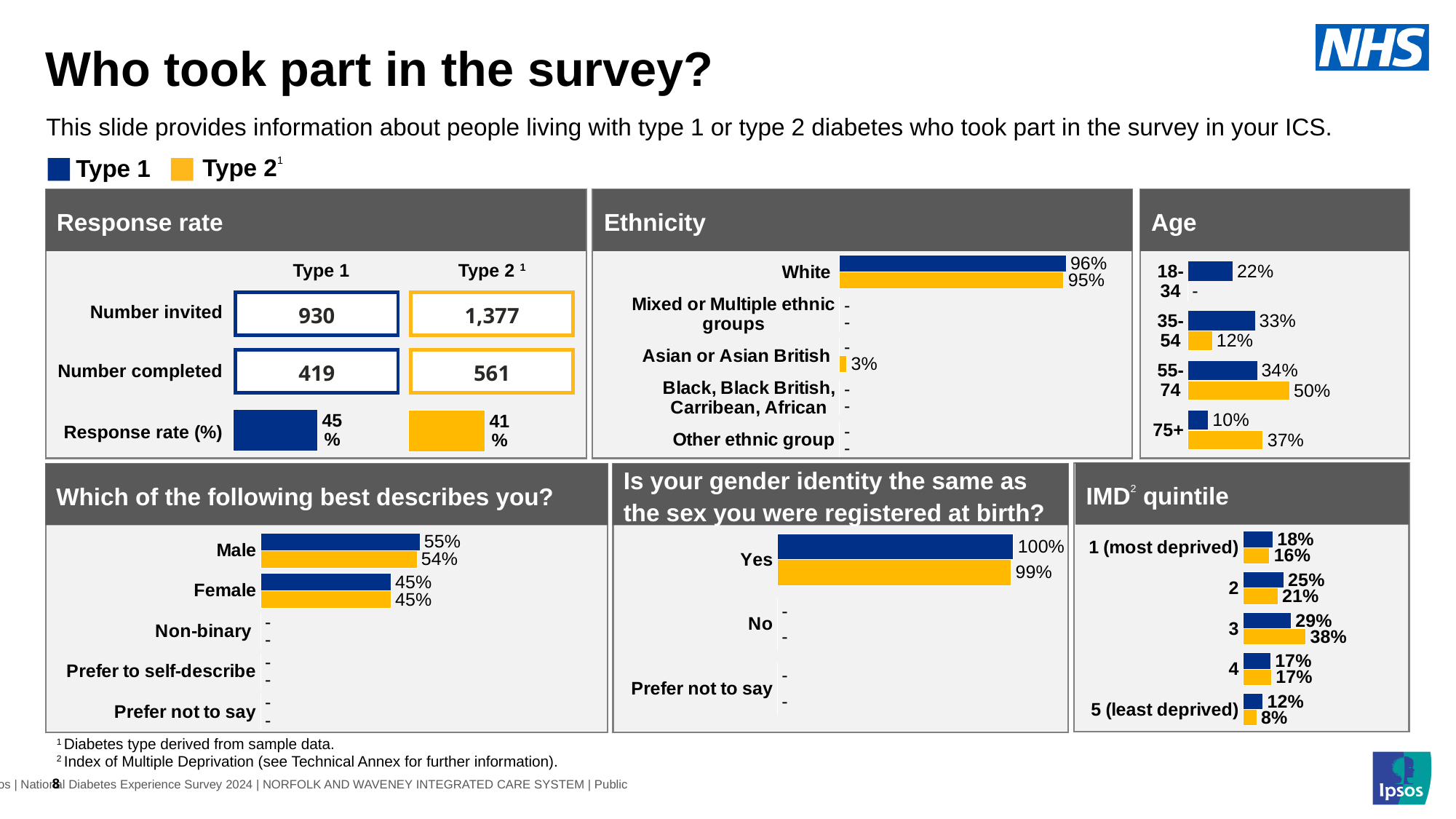
In the Age chart, which age group has the highest Type 2 value? 55-74 In the Ethnicity chart, what is the Type 1 value for White? 96% In the IMD quintile chart, which quintile has the highest Type 1 value? 3 In the Response rate chart, what is the number completed for Type 2? 561 In the IMD quintile chart, what is the difference between the Type 2 and Type 1 values for quintile 3? 9% In the Response rate chart, what is the difference between the number invited for Type 2 and Type 1? 447 What type of chart is the Ethnicity chart? bar chart How many categories are shown in the IMD quintile chart? 5 In the 'Which of the following best describes you?' chart, is the Type 1 value for Male larger or smaller than the Type 2 value for Male? larger In the 'Is your gender identity the same as the sex you were registered at birth?' chart, what is the Type 2 value for Yes? 99% In the Age chart, what is the Type 2 value for the 55-74 age group? 50% In the Age chart, which age group has the lowest Type 1 value? 75+